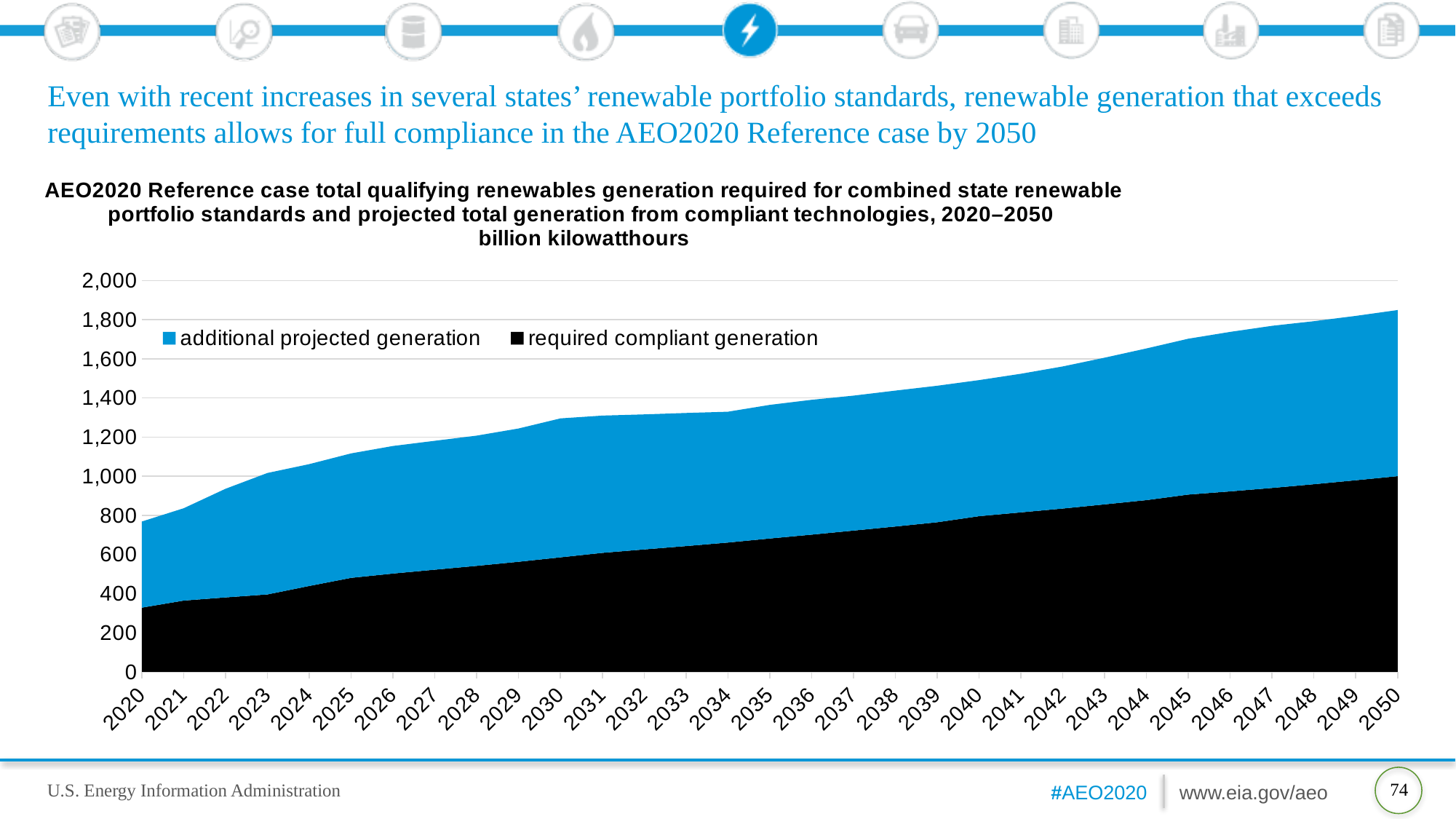
Does the total projected generation from compliant technologies rise or fall over the period shown? rise In what unit are the values on the chart expressed? billion kilowatthours How many years are plotted along the x axis? 31 Does the required compliant generation rise or fall from 2020 to 2050? rise What is the first year shown on the x axis? 2020 What is the last year shown on the x axis? 2050 Is the total generation from compliant technologies in 2030 greater or less than 1,200? greater How many series does the legend list? 2 Is the value for required compliant generation in 2020 greater or less than 400? less What kind of chart is shown on the slide? stacked area chart Which colour represents additional projected generation in the chart? blue Is the total generation from compliant technologies in 2050 greater or less than 1,800? greater